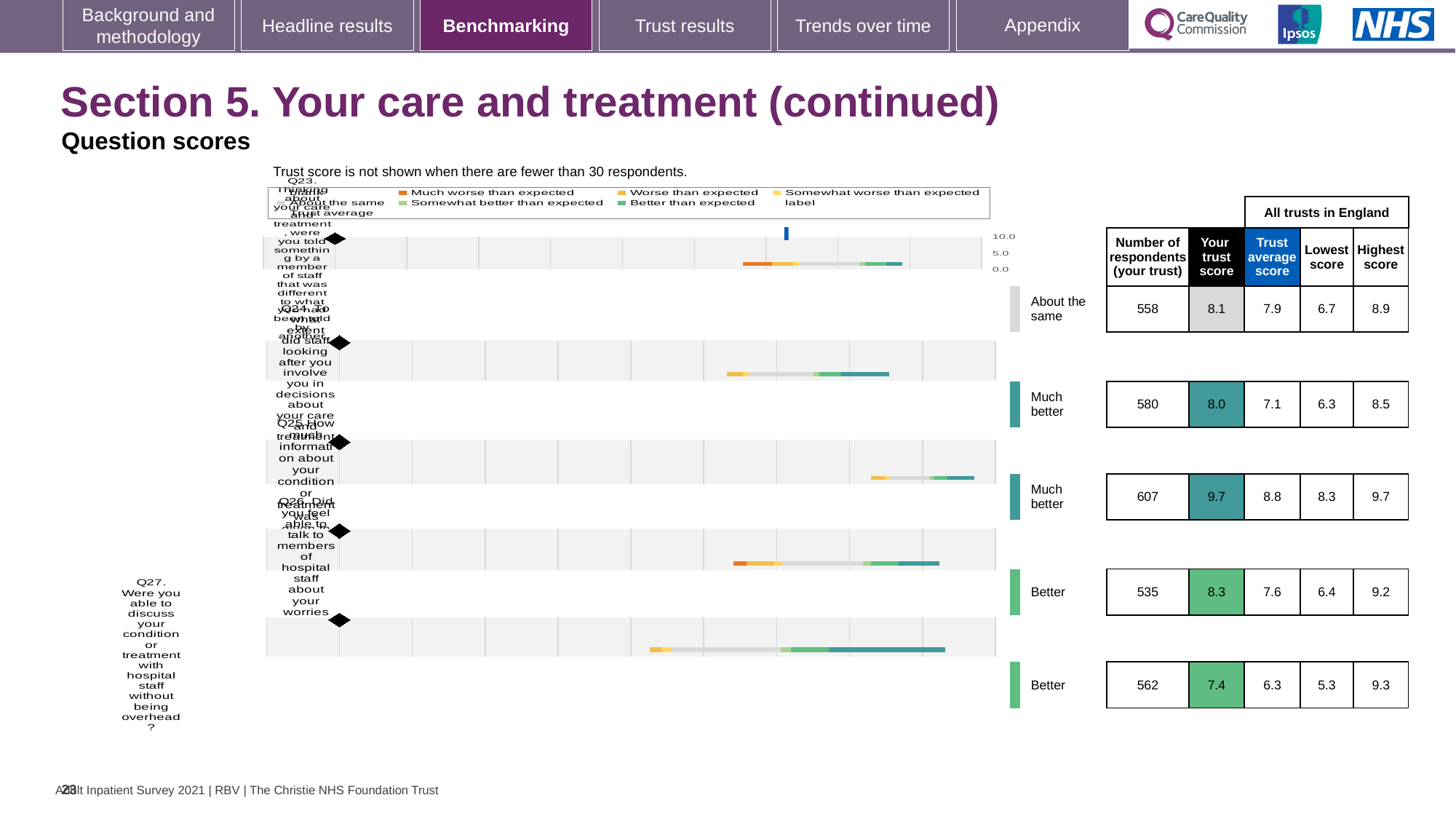
What kind of chart is used to show the question scores? Bar chart Which question has the highest 'Your trust score' on this slide? Q25 Which question has the lowest 'Your trust score' on this slide? Q27 What benchmark rating is given for Q23? About the same What is the lowest score across all trusts in England for Q26 (did you feel able to talk to members of hospital staff about your worries)? 6.4 For Q25, what is the difference between your trust score and the trust average score? 0.9 How many questions (Q23 to Q27) are shown on this slide? 5 How many respondents from your trust answered Q25 (how much information about your condition or treatment was given to you)? 607 What is the highest score across all trusts in England for Q27? 9.3 What benchmark rating is given for Q27 (were you able to discuss your condition or treatment with hospital staff without being overheard)? Better What is the 'Your trust score' for Q24 (did staff looking after you involve you in decisions about your care and treatment)? 8.0 For Q23, which is larger: your trust score or the trust average score? Your trust score